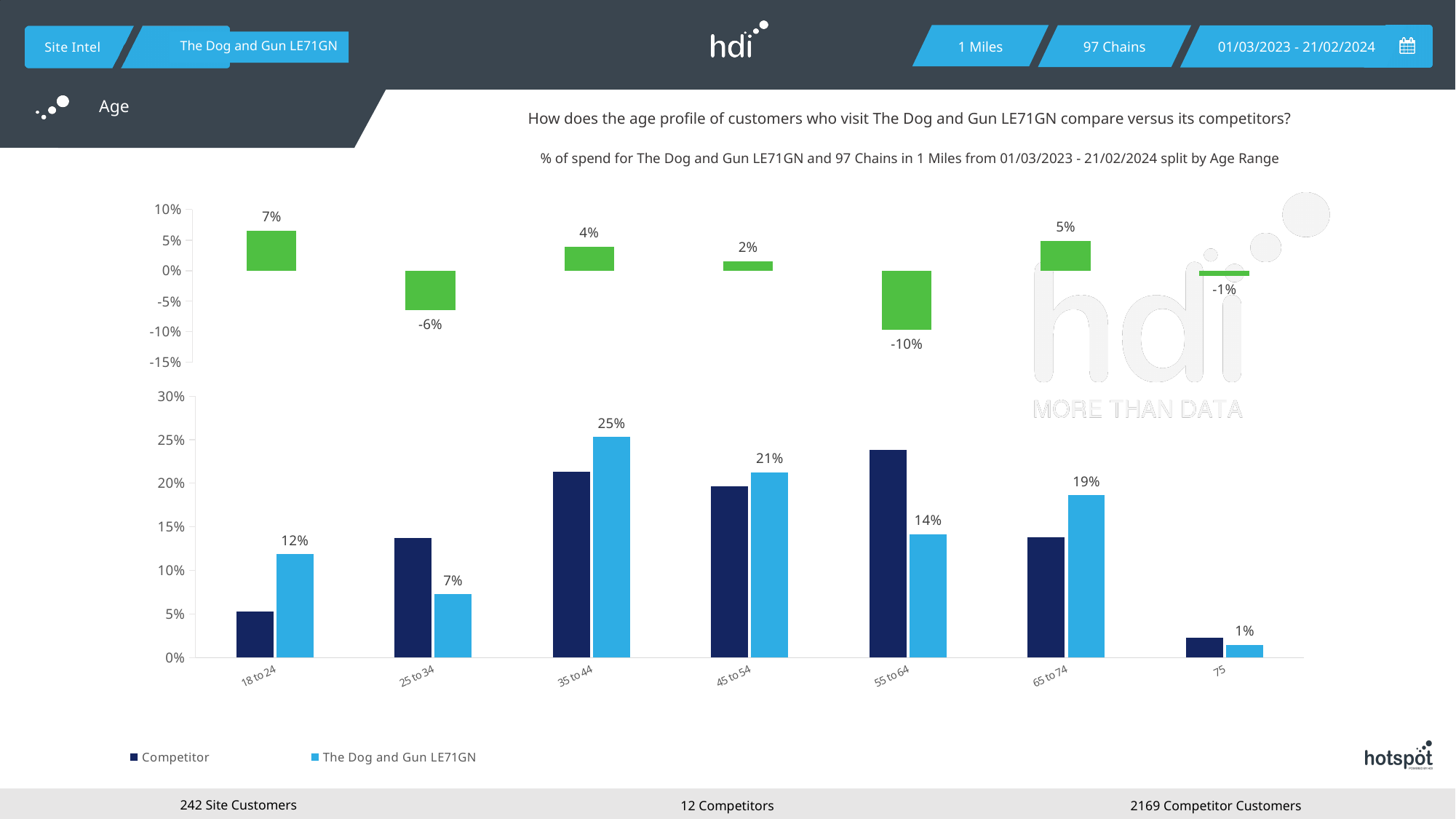
In the top difference chart, what is the value shown for the 18 to 24 age range? 7% How many series does the legend of the bottom bar chart list? 2 In the top difference chart, what is the value shown for the 55 to 64 age range? -10% In the bottom bar chart, what is the value for The Dog and Gun LE71GN in the 35 to 44 age range? 25% In the bottom bar chart, is the Competitor value for 55 to 64 greater or less than 20%? greater In the bottom bar chart, which age range has the highest value for The Dog and Gun LE71GN? 35 to 44 In the bottom bar chart, what is the value for The Dog and Gun LE71GN in the 18 to 24 age range? 12% How many age range categories are shown on the bottom bar chart? 7 In the top difference chart, which age range has the lowest value? 55 to 64 In the bottom bar chart, what is the difference between The Dog and Gun LE71GN values for 35 to 44 and 65 to 74? 6% In the bottom bar chart, which is larger for the 55 to 64 age range: Competitor or The Dog and Gun LE71GN? Competitor In the bottom bar chart, which age range has the lowest value for The Dog and Gun LE71GN? 75